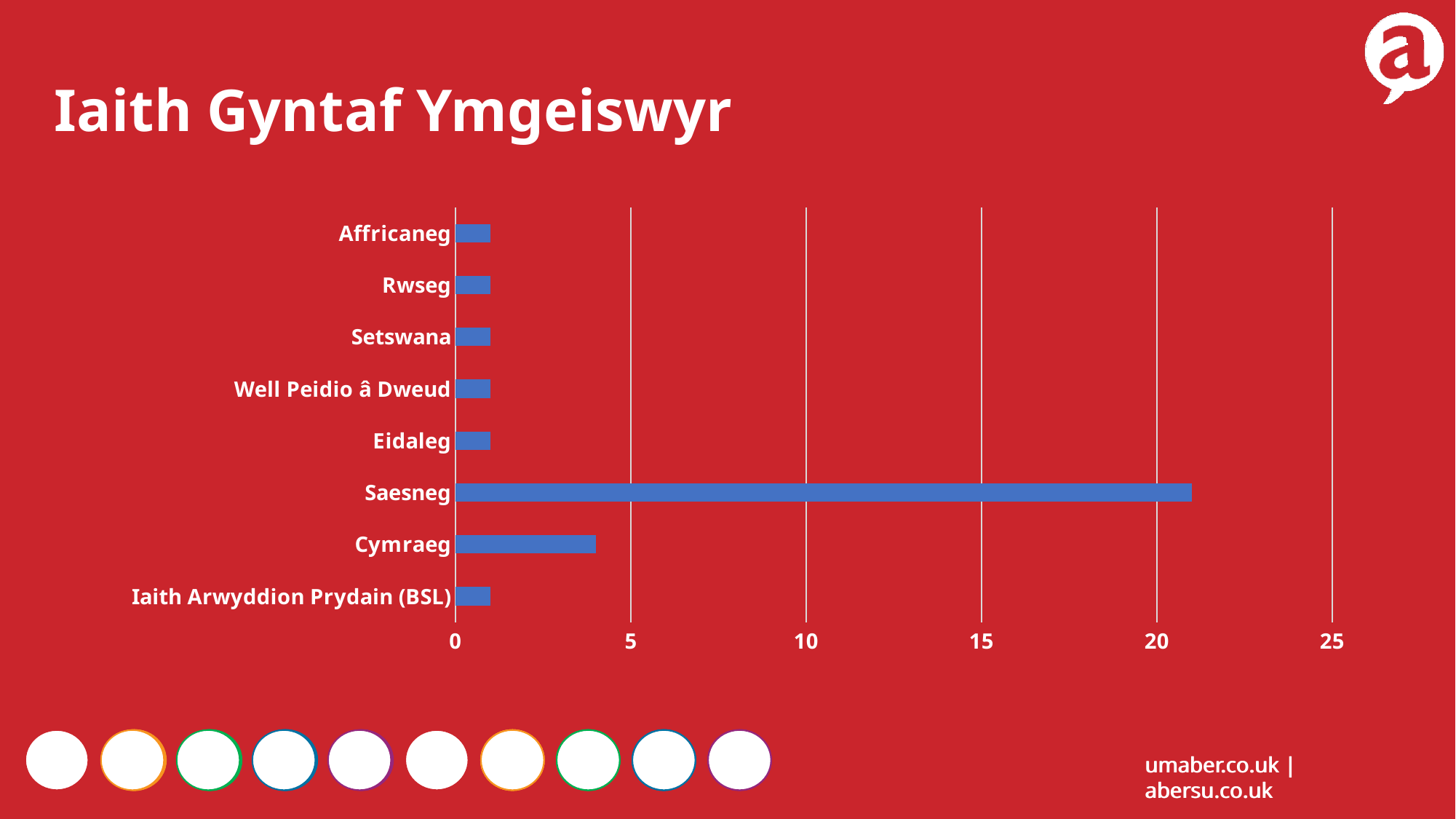
Is the value for Saesneg greater or less than 25? less Is the value for Affricaneg greater or less than 5? less What is the highest value shown on the horizontal axis? 25 Which is larger, the value for Saesneg or the value for Cymraeg? Saesneg What is the title of the chart? Iaith Gyntaf Ymgeiswyr Which category has the highest value? Saesneg Which is larger, the value for Cymraeg or the value for Eidaleg? Cymraeg How many categories are shown in the chart? 8 What type of chart is shown on the slide? bar chart Which is larger, the value for Cymraeg or the value for Iaith Arwyddion Prydain (BSL)? Cymraeg Is the value for Saesneg greater or less than 20? greater